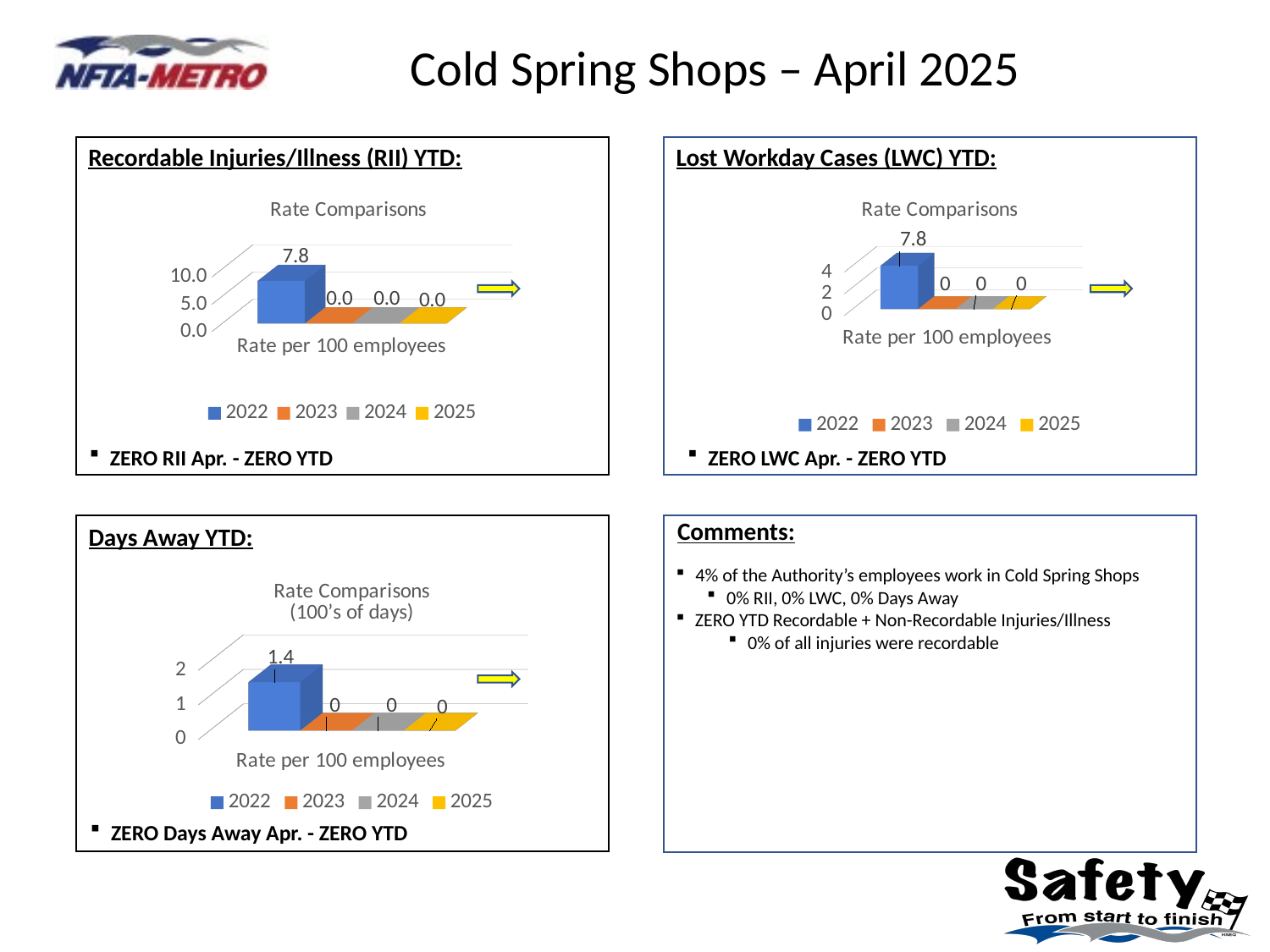
How many series does the legend of the Days Away YTD chart list? 4 In the Days Away YTD chart, which year has the highest value? 2022 In the Lost Workday Cases (LWC) YTD chart, what is the value for 2022? 7.8 In the Recordable Injuries/Illness (RII) YTD chart, what is the difference between the 2022 value and the 2023 value? 7.8 In the Lost Workday Cases (LWC) YTD chart, what is the value for 2024? 0 In the Days Away YTD chart, what is the value for 2022? 1.4 In the Recordable Injuries/Illness (RII) YTD chart, what is the value for 2025? 0.0 In the Recordable Injuries/Illness (RII) YTD chart, what is the value for 2022? 7.8 In the Lost Workday Cases (LWC) YTD chart, which is larger, the value for 2022 or the value for 2025? 2022 What kind of chart is the Lost Workday Cases (LWC) YTD chart? Bar chart In the Days Away YTD chart, what is the value for 2023? 0 What is the title of the chart in the Days Away YTD box? Rate Comparisons (100's of days)